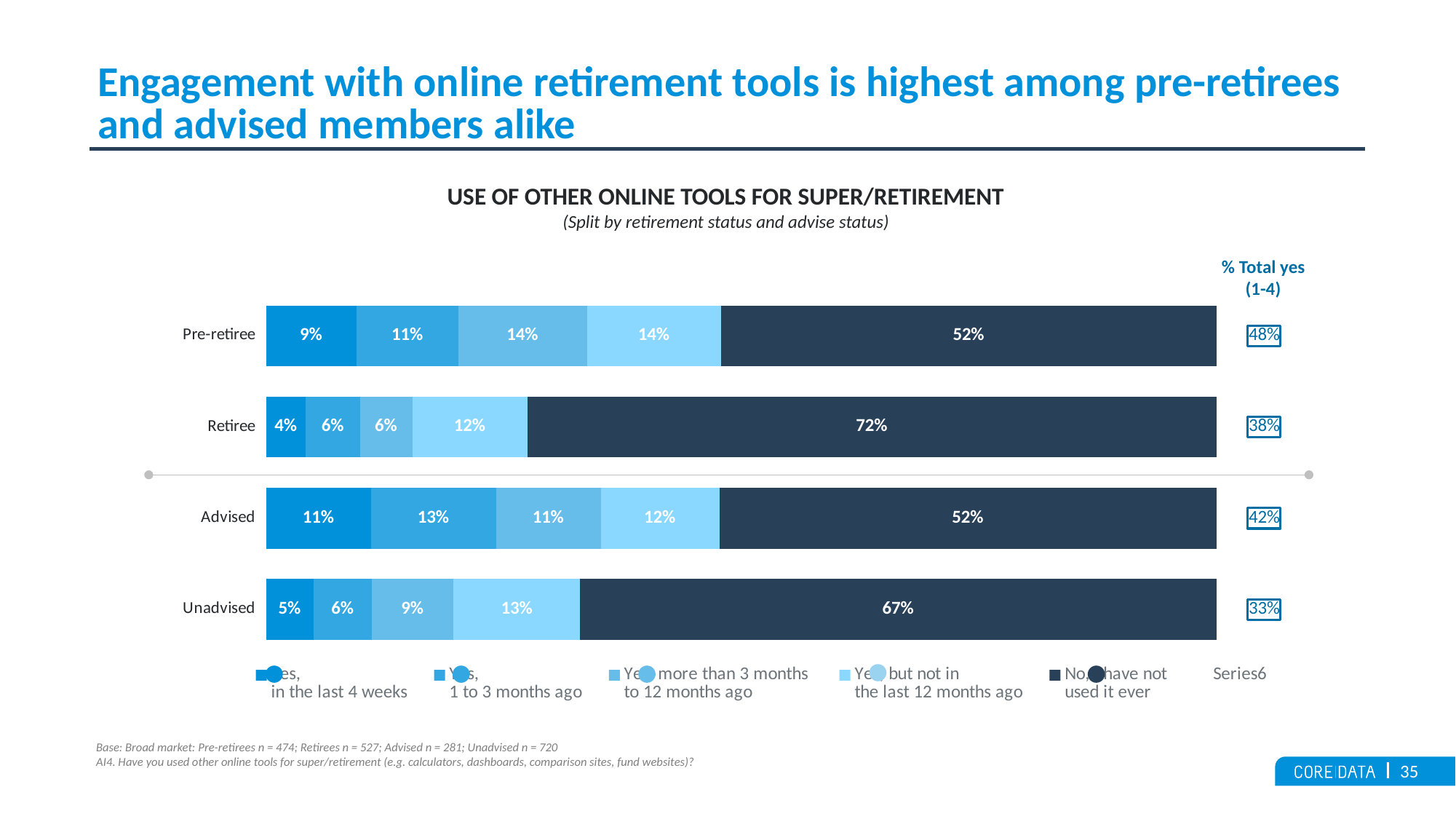
How many categories (groups) are plotted in the chart? 4 What is the difference between the Retiree and Pre-retiree shares for 'No, I have not used it ever'? 20 percentage points Which group has the lowest share answering 'Yes, in the last 4 weeks'? Retiree Which group has a larger share for 'Yes, 1 to 3 months ago': Advised or Unadvised? Advised What kind of chart is shown on the slide? Stacked horizontal bar chart Which group has the highest share answering 'No, I have not used it ever'? Retiree What is the title of the chart? USE OF OTHER ONLINE TOOLS FOR SUPER/RETIREMENT What is the '% Total yes (1-4)' value shown for Unadvised? 33% What percentage of Advised members answered 'Yes, but not in the last 12 months ago'? 12% What percentage of Pre-retirees answered 'No, I have not used it ever'? 52% Which group has the highest '% Total yes (1-4)' value? Pre-retiree What percentage of Retirees answered 'Yes, in the last 4 weeks'? 4%